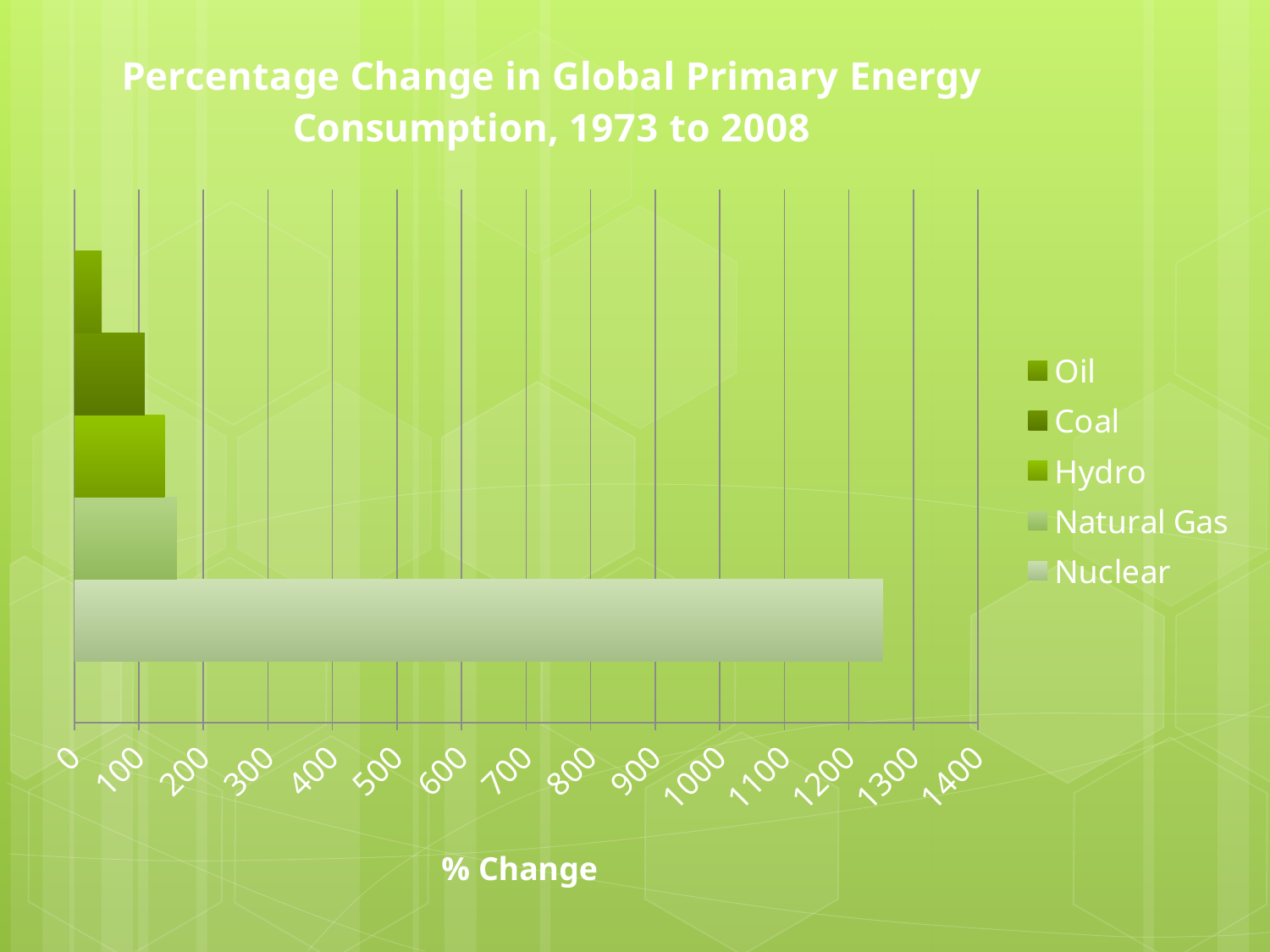
How many bars are plotted in the chart? 5 Is the value for Nuclear greater or less than 1200? greater Is the value for Natural Gas greater or less than 100? greater Which energy source shows the highest percentage change? Nuclear Is the value for Oil greater or less than 100? less Which has the larger percentage change, Natural Gas or Coal? Natural Gas How many series does the legend list? 5 What kind of chart is shown on the slide? bar chart Which energy source shows the lowest percentage change? Oil What is the title of the horizontal axis? % Change